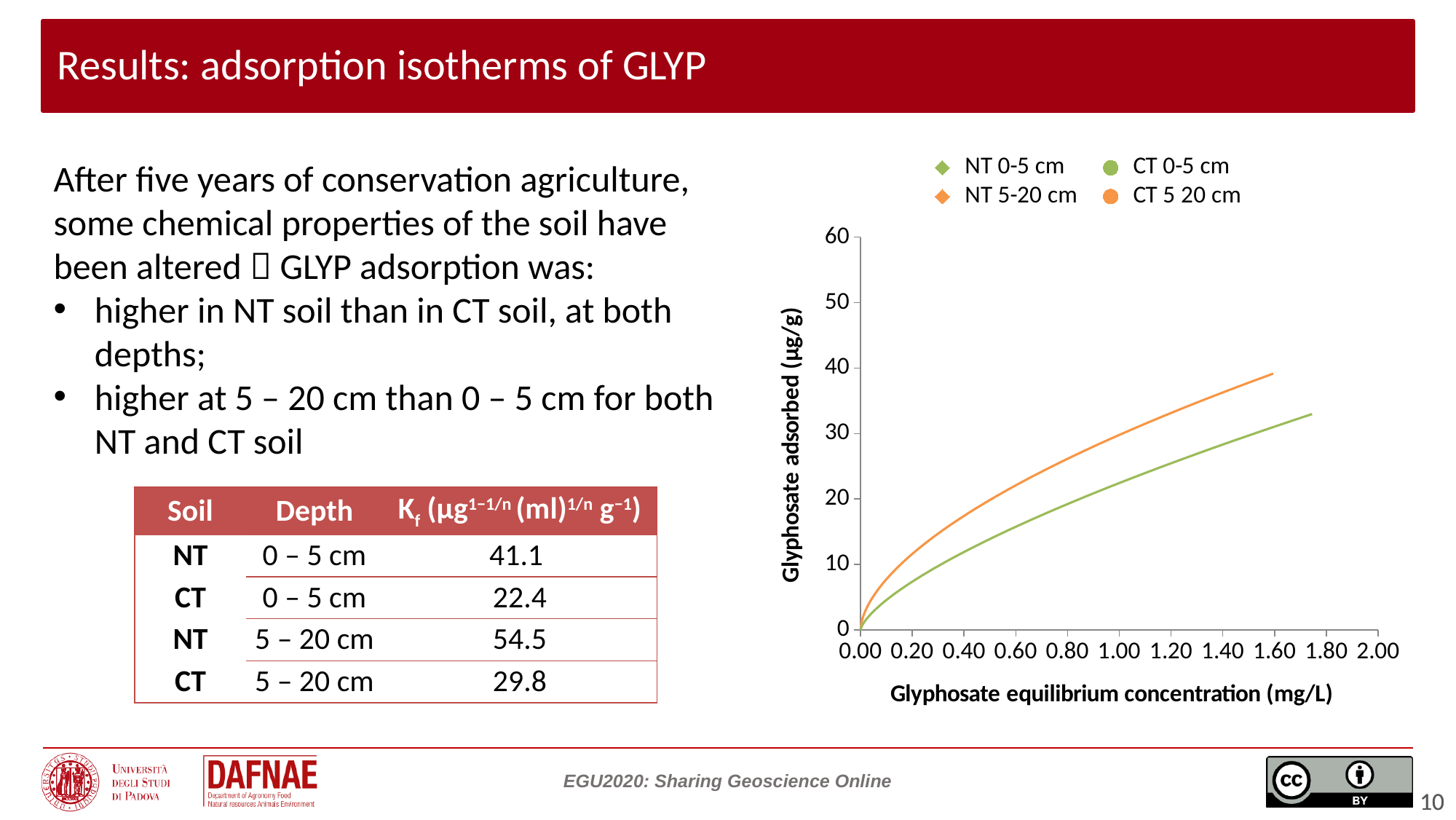
What is the label of the y axis of the chart? Glyphosate adsorbed (µg/g) Which curve is higher at an equilibrium concentration of 1.00 mg/L, the orange one or the green one? orange Do the plotted curves rise or fall as the glyphosate equilibrium concentration increases? rise What is the highest tick value shown on the y axis of the chart? 60 Is the value of the orange curve at an equilibrium concentration of 0.40 mg/L greater or less than 20? less Is the value of the orange curve at an equilibrium concentration of 1.60 mg/L greater or less than 30? greater Is the value of the green curve at an equilibrium concentration of 0.40 mg/L greater or less than 10? greater How many series does the chart legend list? 4 What kind of chart is shown on the slide? line chart What is the label of the x axis of the chart? Glyphosate equilibrium concentration (mg/L)